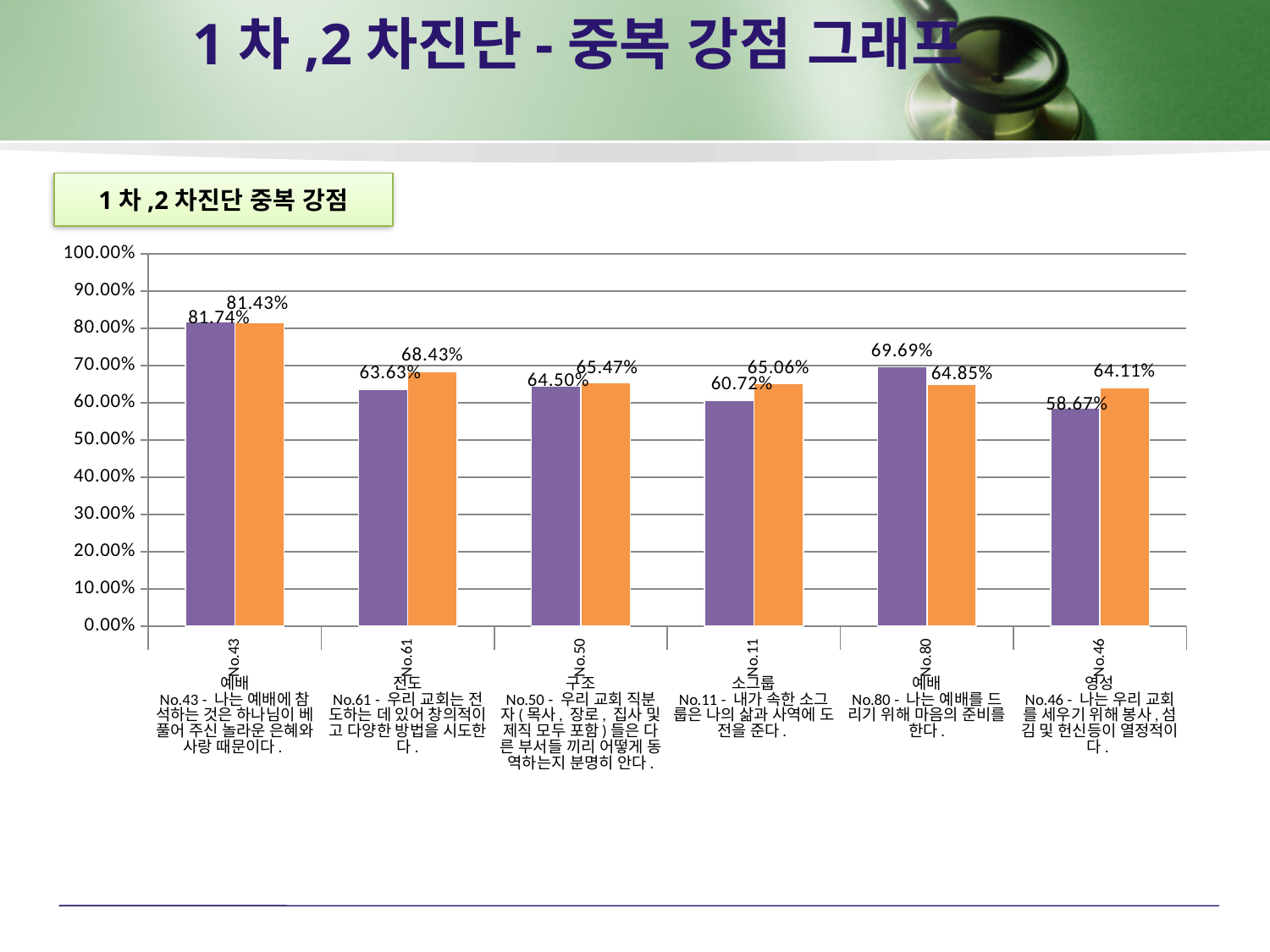
How many categories are shown on the x axis of the chart? 6 Is the purple bar for No.46 greater or less than 60.00%? less Which category has the highest orange bar? No.43 What is the value of the purple bar for No.43? 81.74% What is the difference between the orange and purple bars for No.11? 4.34% What is the value of the purple bar for No.80? 69.69% What type of chart is shown on the slide? bar chart What is the title shown in the box above the chart? 1 차 ,2 차진단 중복 강점 For No.80, which bar is larger, the purple or the orange? purple What is the value of the orange bar for No.61? 68.43% What is the value of the orange bar for No.46? 64.11% Which category has the lowest purple bar? No.46